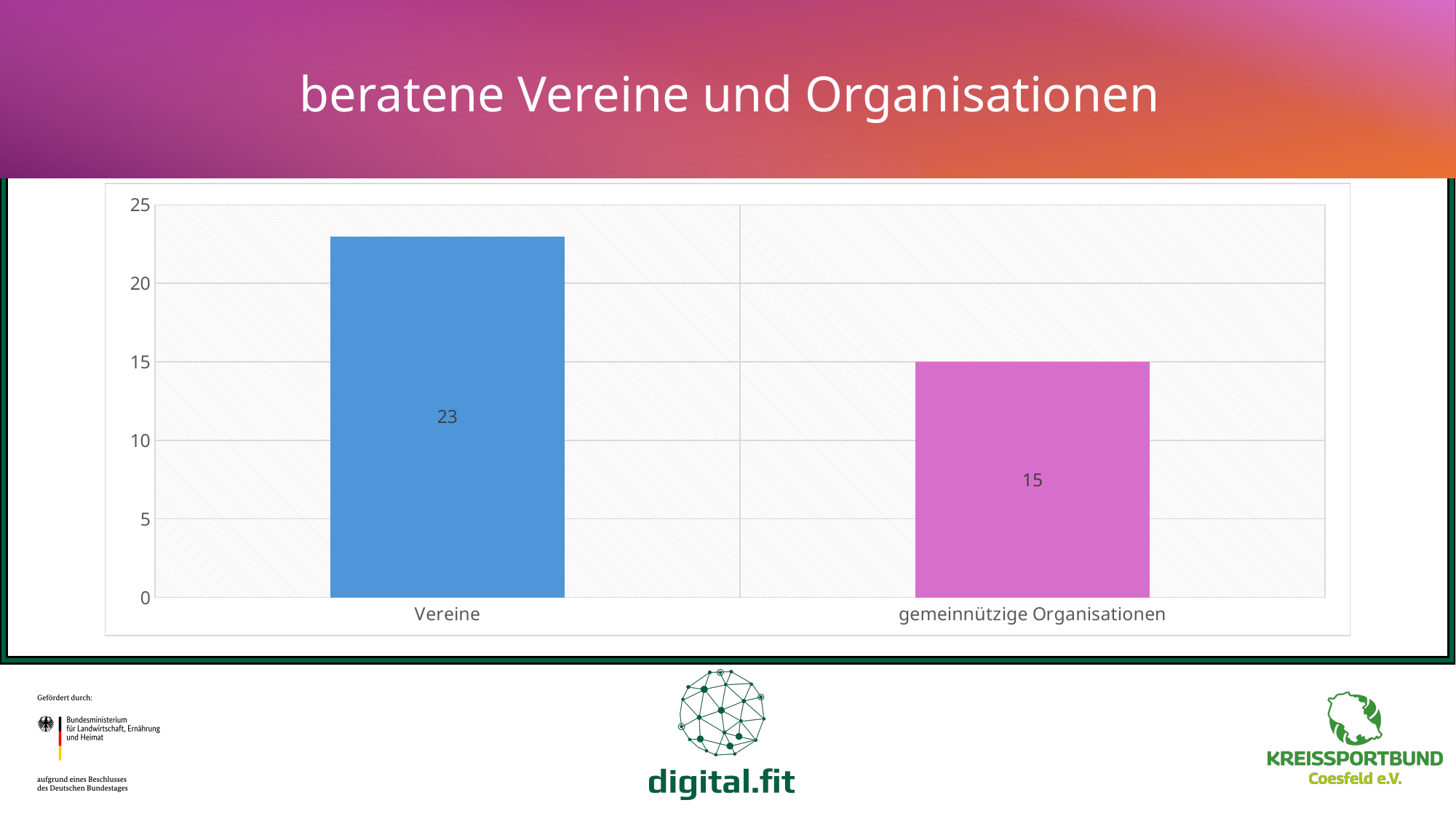
What kind of chart is shown on the slide? bar chart What colour is the bar for Vereine? blue Which is larger, the value for Vereine or the value for gemeinnützige Organisationen? Vereine Which category has the lowest value? gemeinnützige Organisationen How many categories are shown on the x axis? 2 What is the value for gemeinnützige Organisationen? 15 Which category has the highest value? Vereine What is the value for Vereine? 23 Is the value for Vereine greater or less than 20? greater What is the title of the slide above the chart? beratene Vereine und Organisationen Is the value for gemeinnützige Organisationen greater or less than 20? less What is the difference between the values for Vereine and gemeinnützige Organisationen? 8